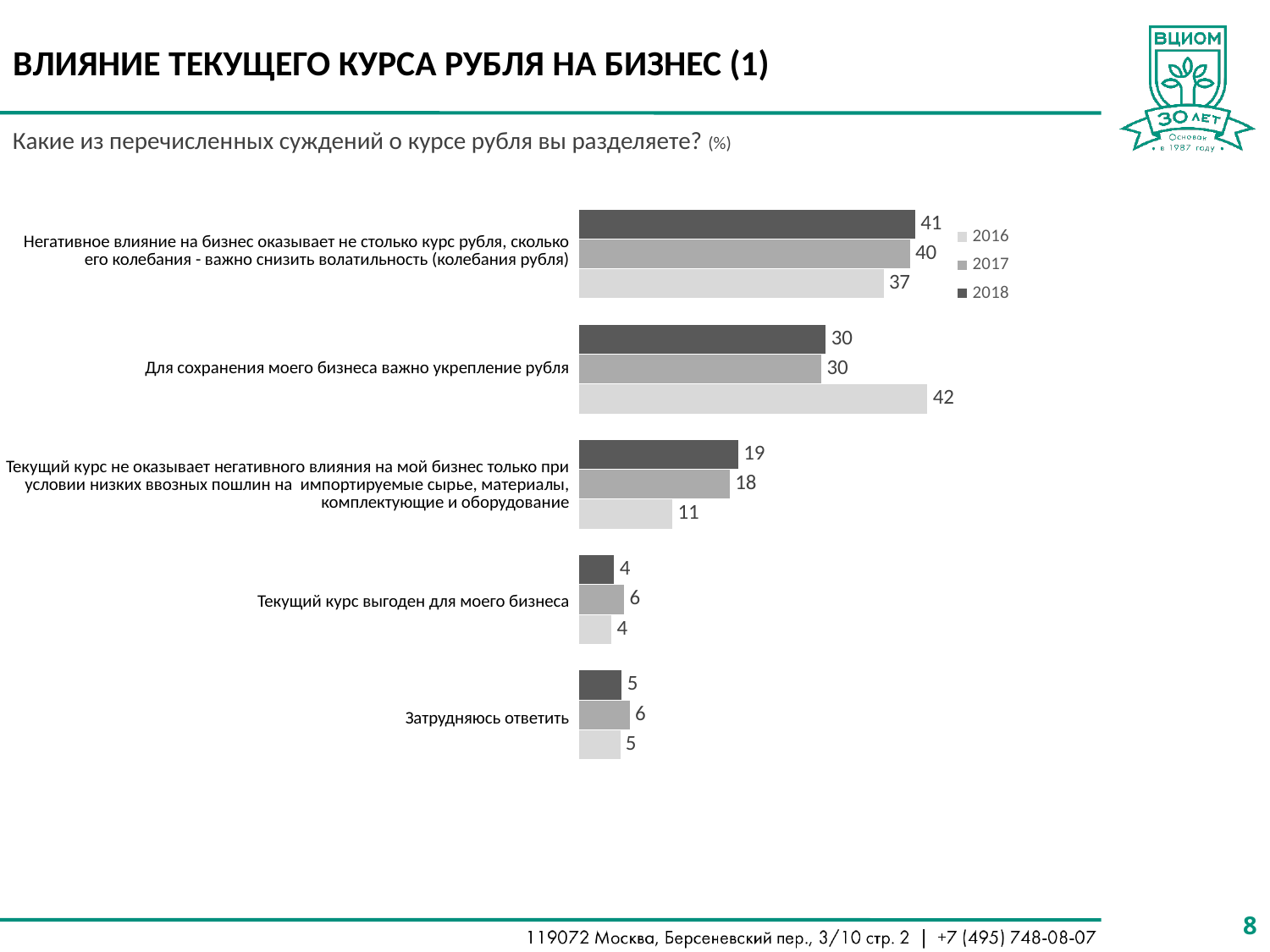
How many series does the legend list? 3 What is the 2018 value for «Негативное влияние на бизнес оказывает не столько курс рубля, сколько его колебания - важно снизить волатильность (колебания рубля)»? 41 What kind of chart is shown on the slide? Bar chart What is the 2016 value for «Для сохранения моего бизнеса важно укрепление рубля»? 42 Which years are listed in the chart legend? 2016, 2017, 2018 How many categories are shown in the chart? 5 What is the 2017 value for «Текущий курс не оказывает негативного влияния на мой бизнес только при условии низких ввозных пошлин на импортируемые сырье, материалы, комплектующие и оборудование»? 18 What is the difference between the 2016 and 2018 values for «Для сохранения моего бизнеса важно укрепление рубля»? 12 What is the 2017 value for «Текущий курс выгоден для моего бизнеса»? 6 For «Текущий курс не оказывает негативного влияния на мой бизнес только при условии низких ввозных пошлин...», which year has the larger value, 2016 or 2018? 2018 Which category has the lowest 2016 value? Текущий курс выгоден для моего бизнеса Which category has the highest 2018 value? Негативное влияние на бизнес оказывает не столько курс рубля, сколько его колебания - важно снизить волатильность (колебания рубля)